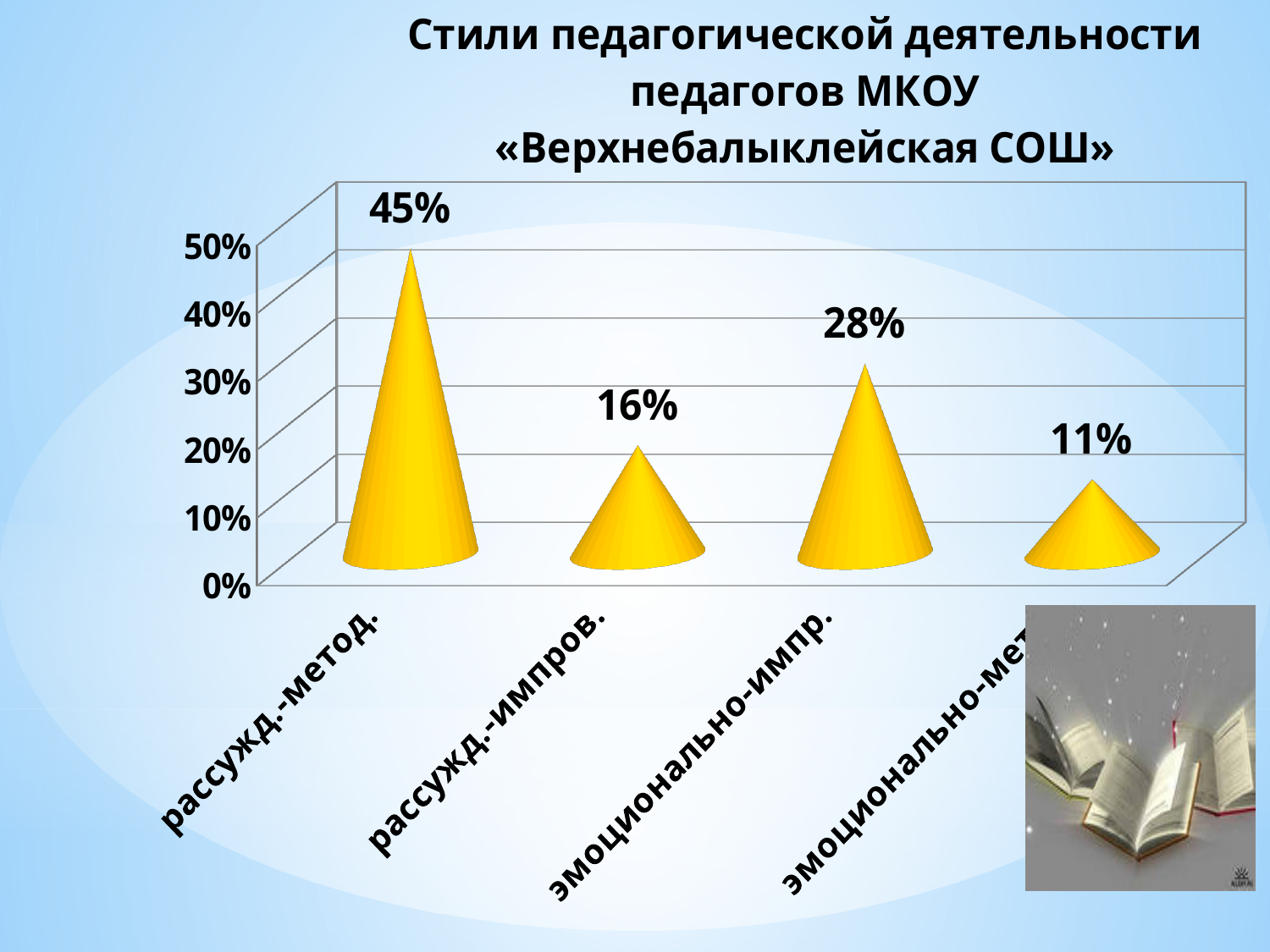
Which category has the lowest value? эмоционально-мет... (the rightmost category) How many categories are shown in the chart? 4 What is the value for the rightmost category (эмоционально-мет...)? 11% Which is larger, the value for рассужд.-импров. or the value for эмоционально-импр.? эмоционально-импр. What is the value for рассужд.-метод.? 45% What is the value for эмоционально-импр.? 28% What is the title of the chart? Стили педагогической деятельности педагогов МКОУ «Верхнебалыклейская СОШ» What is the value for рассужд.-импров.? 16% What is the difference between the values for эмоционально-импр. and рассужд.-импров.? 12% What is the difference between the values for рассужд.-метод. and эмоционально-импр.? 17% Which category has the highest value? рассужд.-метод. What kind of chart is shown on the slide? Bar chart